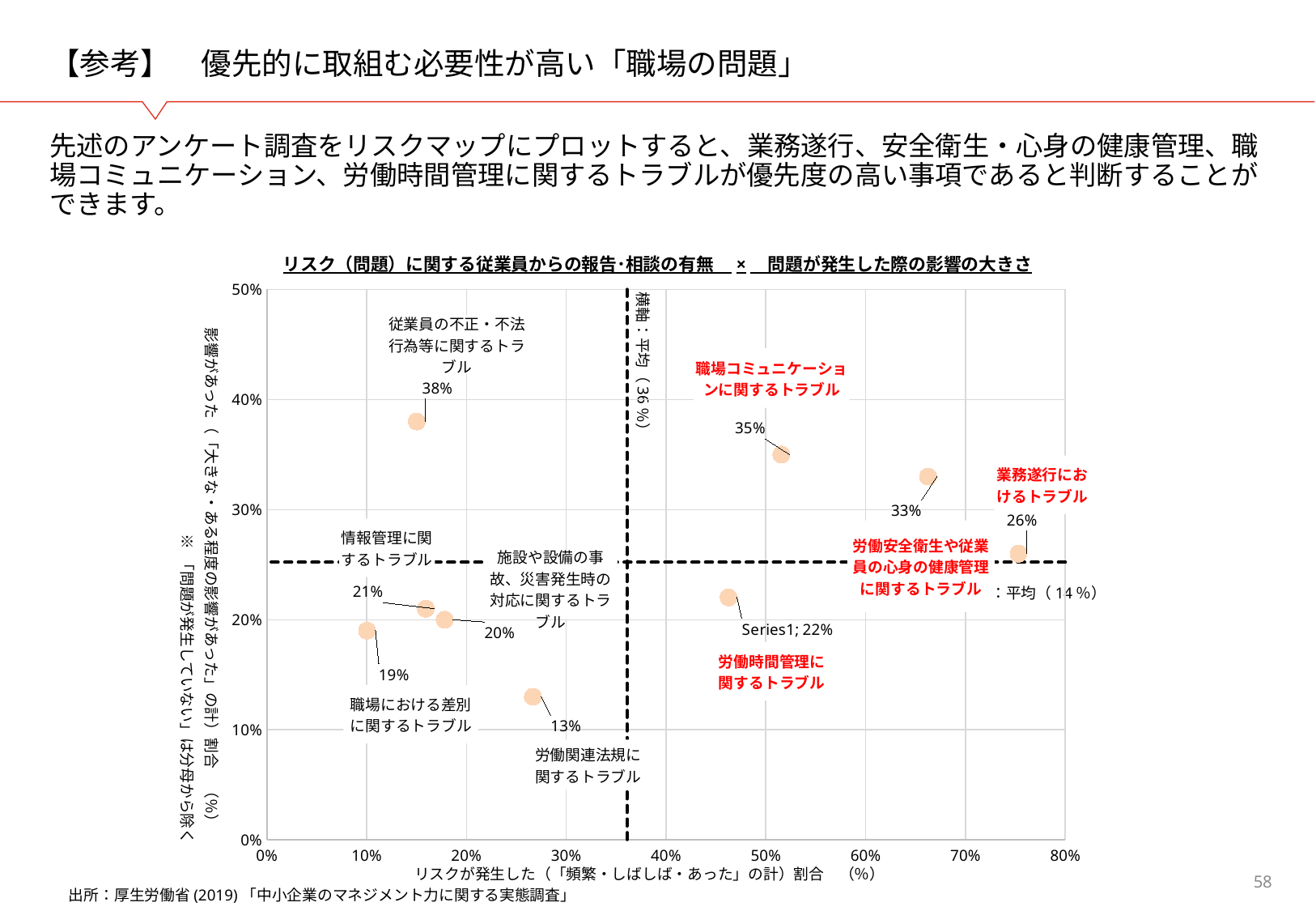
What kind of chart is shown on the slide? scatter chart Which trouble category has the lowest impact percentage on the vertical axis? 労働関連法規に関するトラブル How many data points are plotted on the chart? 9 What is the impact percentage (vertical axis value) for 職場コミュニケーションに関するトラブル? 35% What is the impact percentage (vertical axis value) for 従業員の不正・不法行為等に関するトラブル? 38% What is the impact percentage (vertical axis value) for 労働関連法規に関するトラブル? 13% What is the difference in impact percentage between 従業員の不正・不法行為等に関するトラブル and 労働関連法規に関するトラブル? 25 percentage points Which trouble category has the highest impact percentage on the vertical axis? 従業員の不正・不法行為等に関するトラブル What is the impact percentage (vertical axis value) for 労働時間管理に関するトラブル? 22% Which has a higher impact percentage: 職場コミュニケーションに関するトラブル or 業務遂行におけるトラブル? 職場コミュニケーションに関するトラブル